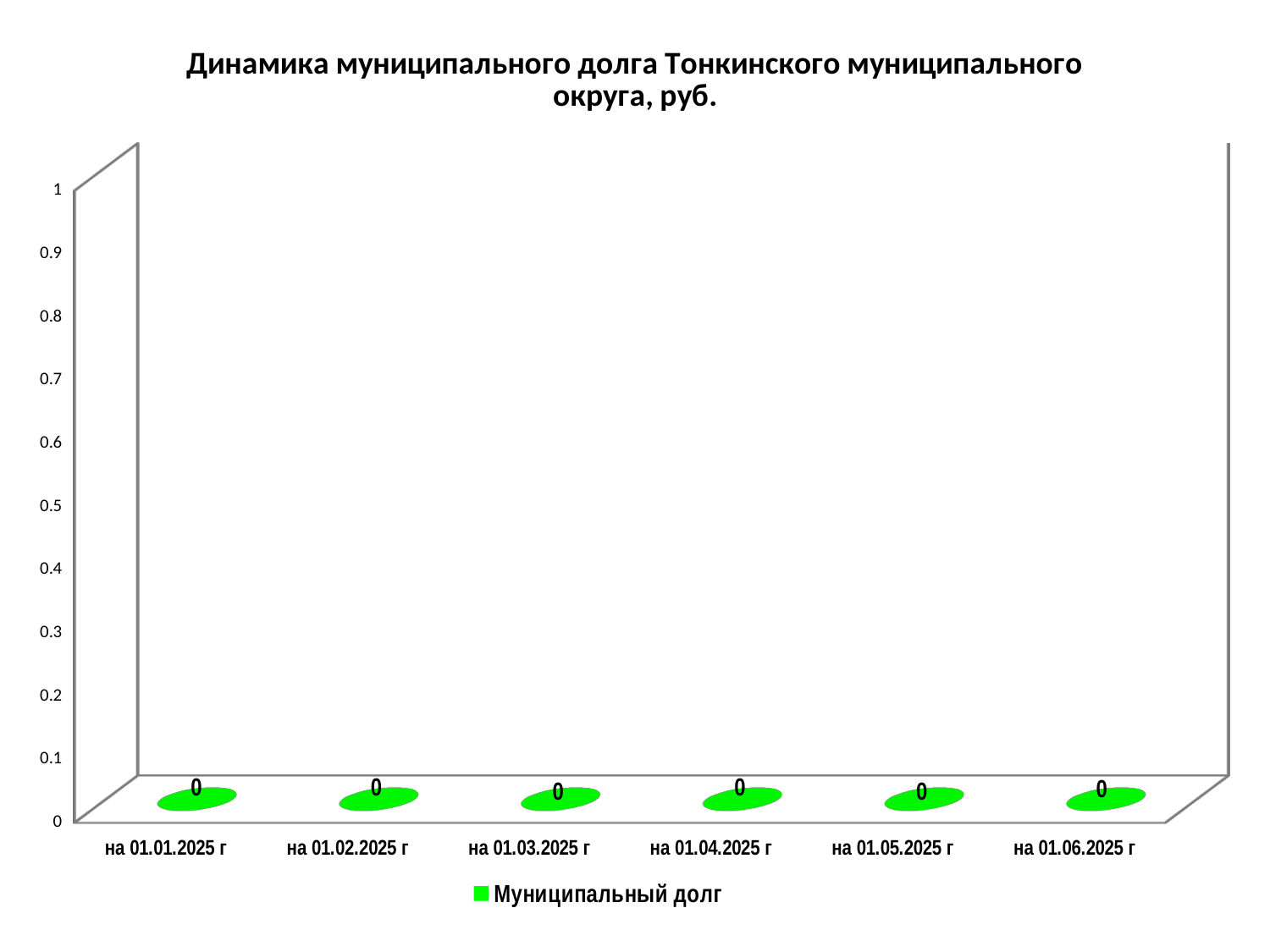
What is the value for "на 01.01.2025 г"? 0 What kind of chart is shown on the slide? bar chart How many series does the legend list? 1 Do the values rise, fall or stay the same from "на 01.01.2025 г" to "на 01.06.2025 г"? stay the same What is the difference between the values for "на 01.02.2025 г" and "на 01.05.2025 г"? 0 What is the value for "на 01.06.2025 г"? 0 What is the name of the series listed in the legend? Муниципальный долг What is the title of the chart? Динамика муниципального долга Тонкинского муниципального округа, руб. What is the value for "на 01.03.2025 г"? 0 Is the value for "на 01.04.2025 г" greater or less than 0.5? less How many categories are shown on the x axis? 6